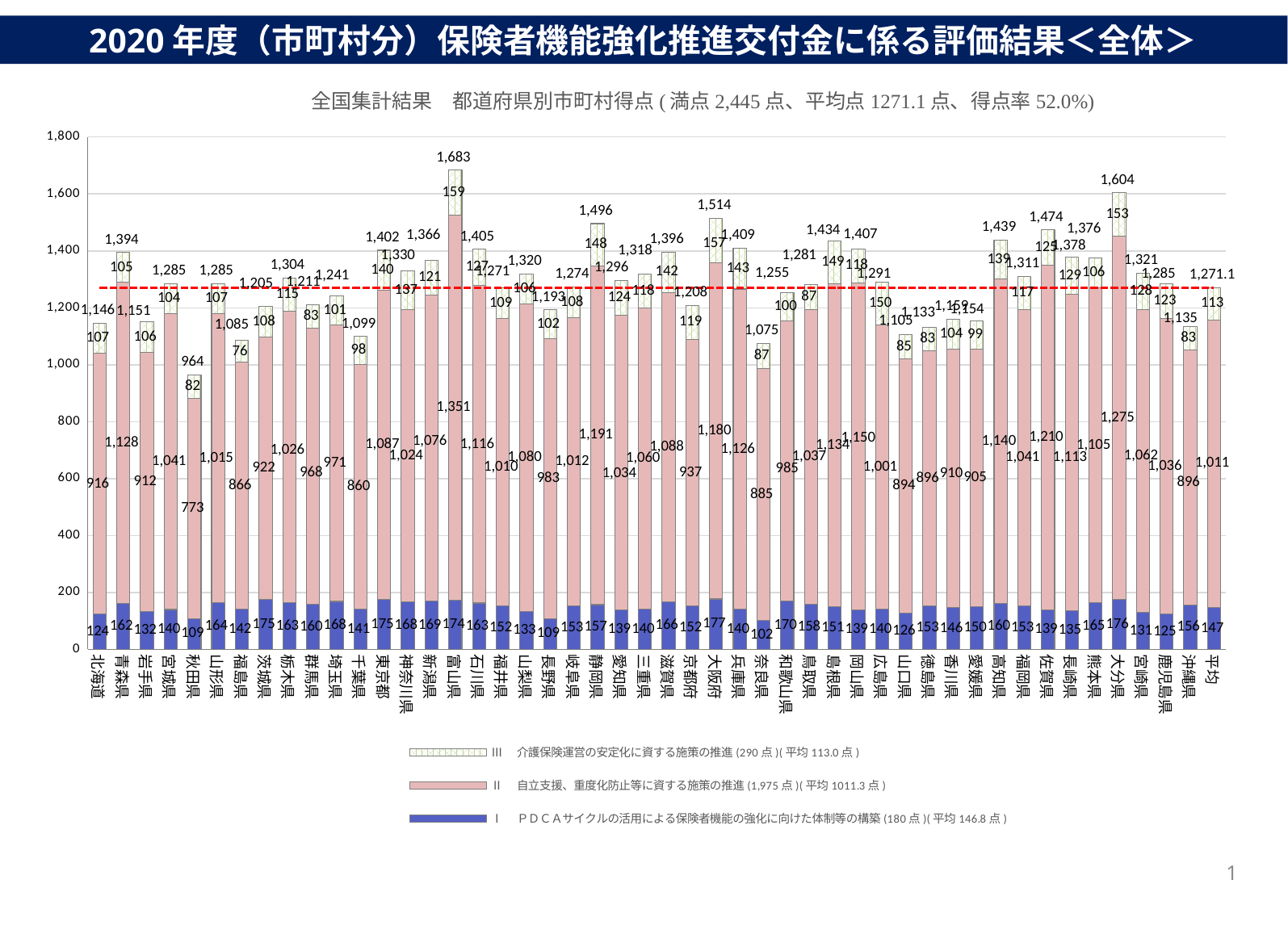
What is the difference between the total scores of 富山県 and 大分県? 79 Which prefecture has the highest total score? 富山県 (1,683) How many series does the legend list? 3 What is the value of series II (pink segment) for 秋田県? 773 Which has a higher total score, 青森県 or 岩手県? 青森県 What value does the 平均 (average) bar show as its total? 1,271.1 What is the total score for 北海道? 1,146 What is the value of series I (blue segment) for 大阪府? 177 Which prefecture has the lowest total score? 秋田県 (964) What is the total score for 大分県? 1,604 What kind of chart is shown on the slide? Stacked bar chart with a dashed average line Is the total score for 秋田県 greater or less than 1,000? less